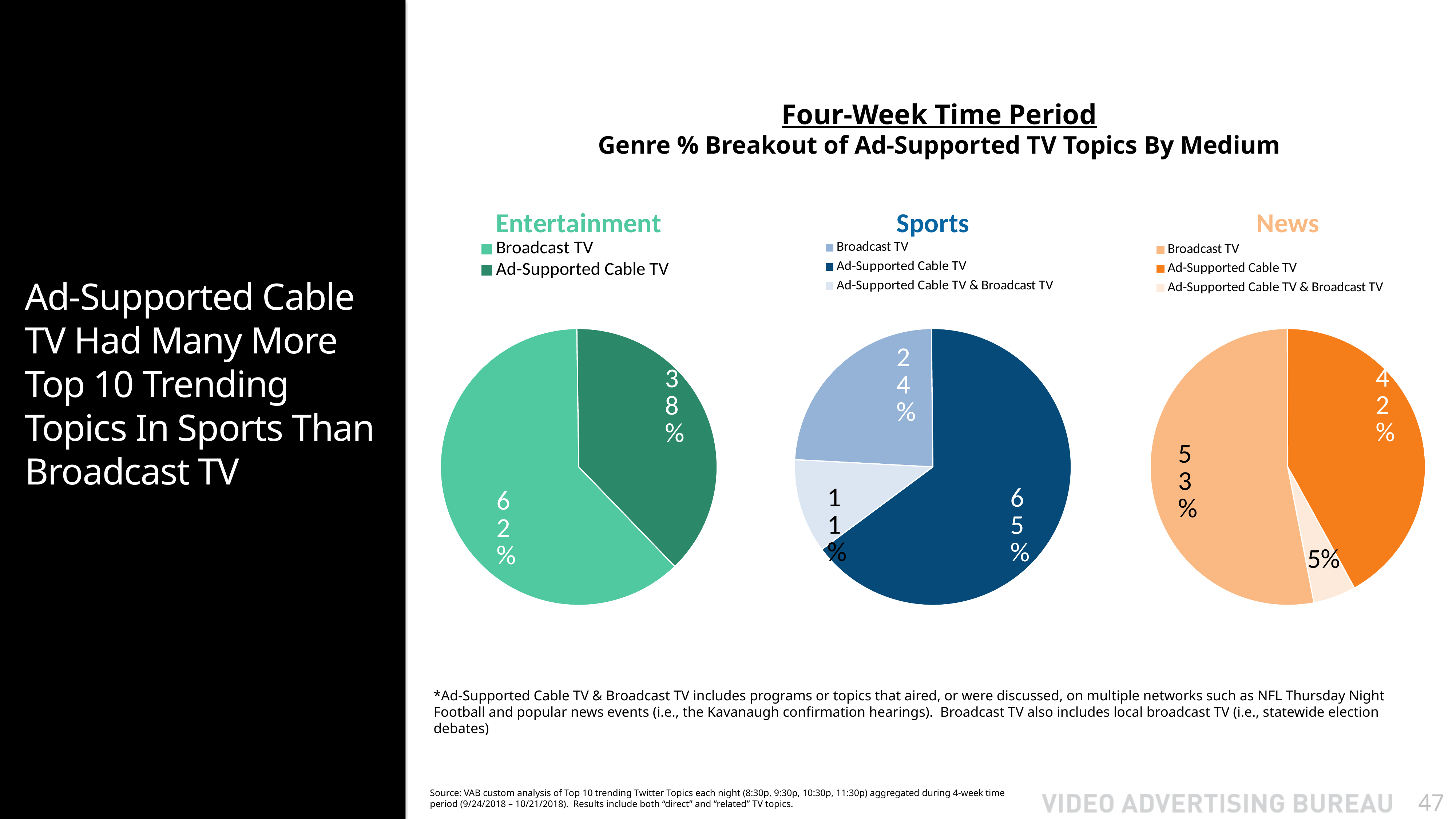
In the News pie chart, which is larger, Broadcast TV or Ad-Supported Cable TV? Broadcast TV In the News pie chart, which slice is the smallest? Ad-Supported Cable TV & Broadcast TV How many slices does the Sports pie chart have? 3 In the Sports pie chart, what share does Ad-Supported Cable TV have? 65% In the Sports pie chart, what is the difference between the Ad-Supported Cable TV share and the Broadcast TV share? 41% In the Entertainment pie chart, what share does Broadcast TV have? 62% In the Entertainment pie chart, what share does Ad-Supported Cable TV have? 38% In the Sports pie chart, what share does Ad-Supported Cable TV & Broadcast TV have? 11% In the Sports pie chart, what share does Broadcast TV have? 24% In the Sports pie chart, which slice is the largest? Ad-Supported Cable TV In the News pie chart, what share does Broadcast TV have? 53% What type of chart is used for the Entertainment, Sports and News breakouts? Pie chart